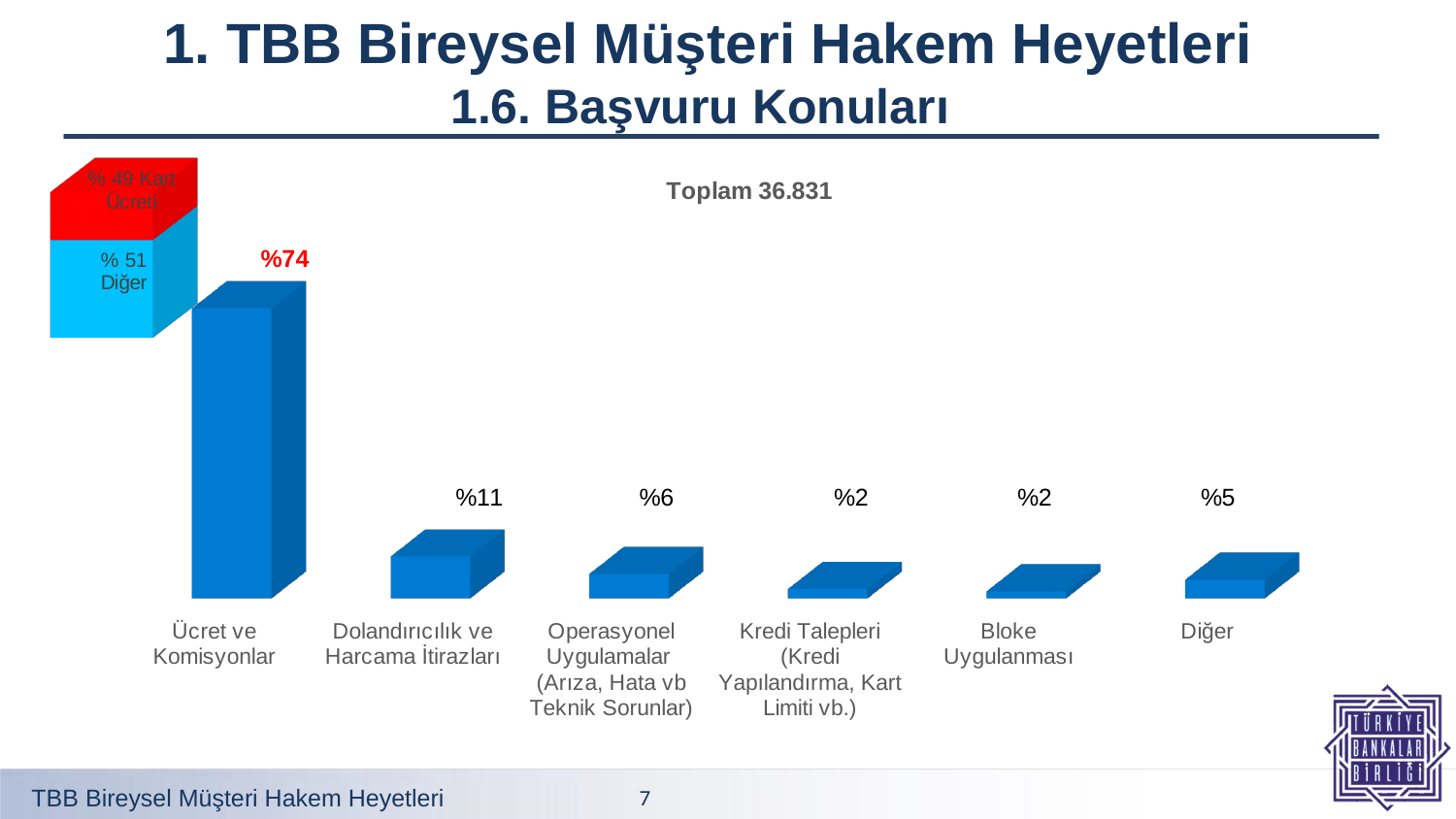
What is the value for Operasyonel Uygulamalar (Arıza, Hata vb Teknik Sorunlar)? %6 What is the value for Dolandırıcılık ve Harcama İtirazları? %11 What total is stated above the chart? Toplam 36.831 What is the value for Bloke Uygulanması? %2 What kind of chart is shown on the slide? Bar chart What is the value for Diğer? %5 What is the value for Ücret ve Komisyonlar? %74 What is the difference between the values for Ücret ve Komisyonlar and Dolandırıcılık ve Harcama İtirazları? 63 percentage points In the small stacked box at the top left, what share is labelled Kart Ücreti? % 49 How many categories are shown in the chart? 6 Which is larger, the value for Diğer or the value for Operasyonel Uygulamalar? Operasyonel Uygulamalar Which category has the highest value? Ücret ve Komisyonlar